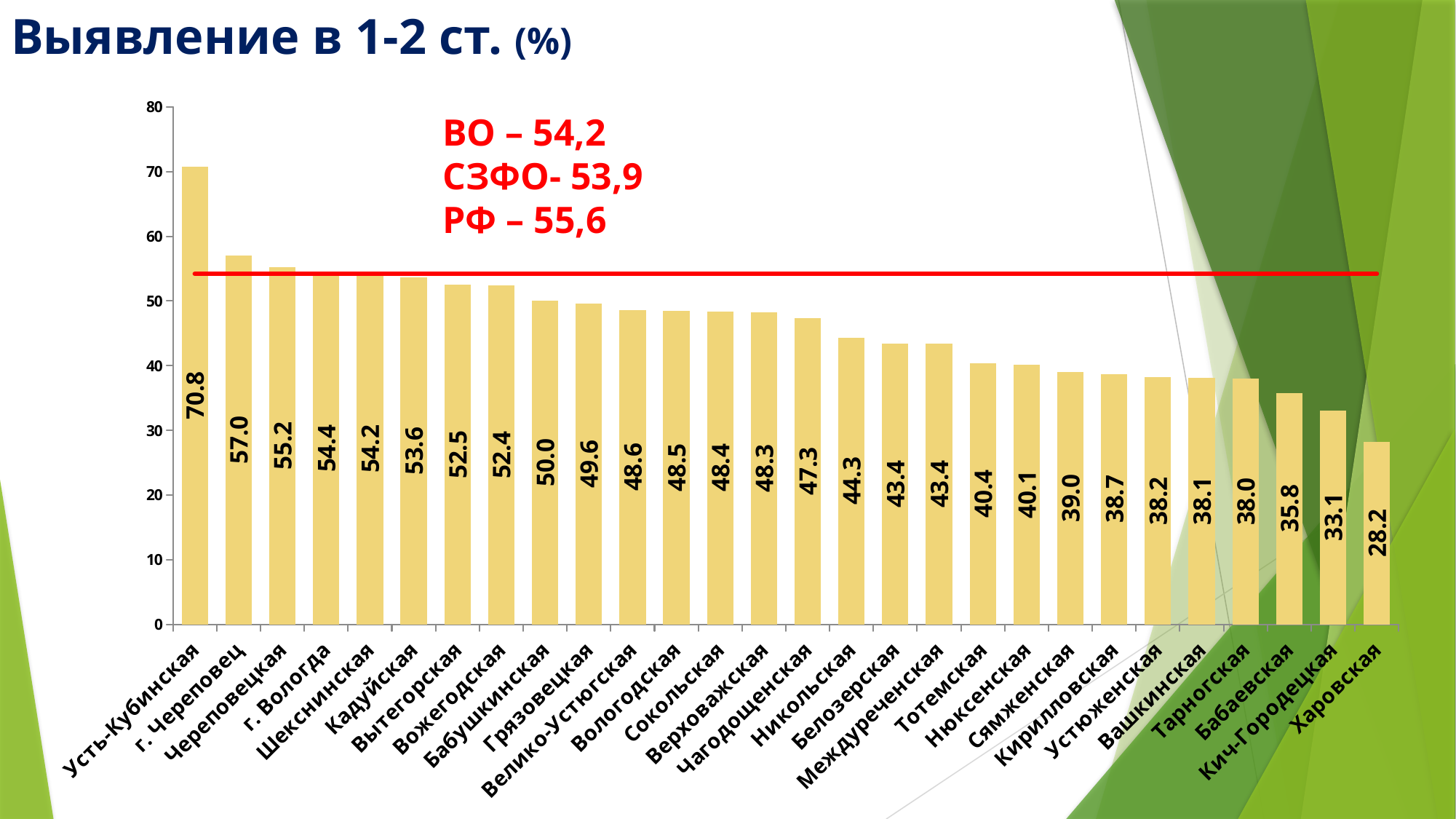
How many categories are shown on the x axis? 28 What is the value for Усть-Кубинская? 70.8 What value is given for РФ in the red text on the slide? 55,6 Which is larger, the value for Кадуйская or the value for Тотемская? Кадуйская Which category has the highest value? Усть-Кубинская What kind of chart is shown on the slide? combination bar and line chart What is the value for Харовская? 28.2 What is the value for Никольская? 44.3 Which category has the lowest value? Харовская Do the values rise or fall from left to right along the x axis? fall What is the difference between the values for Усть-Кубинская and г. Череповец? 13.8 What is the value for г. Вологда? 54.4